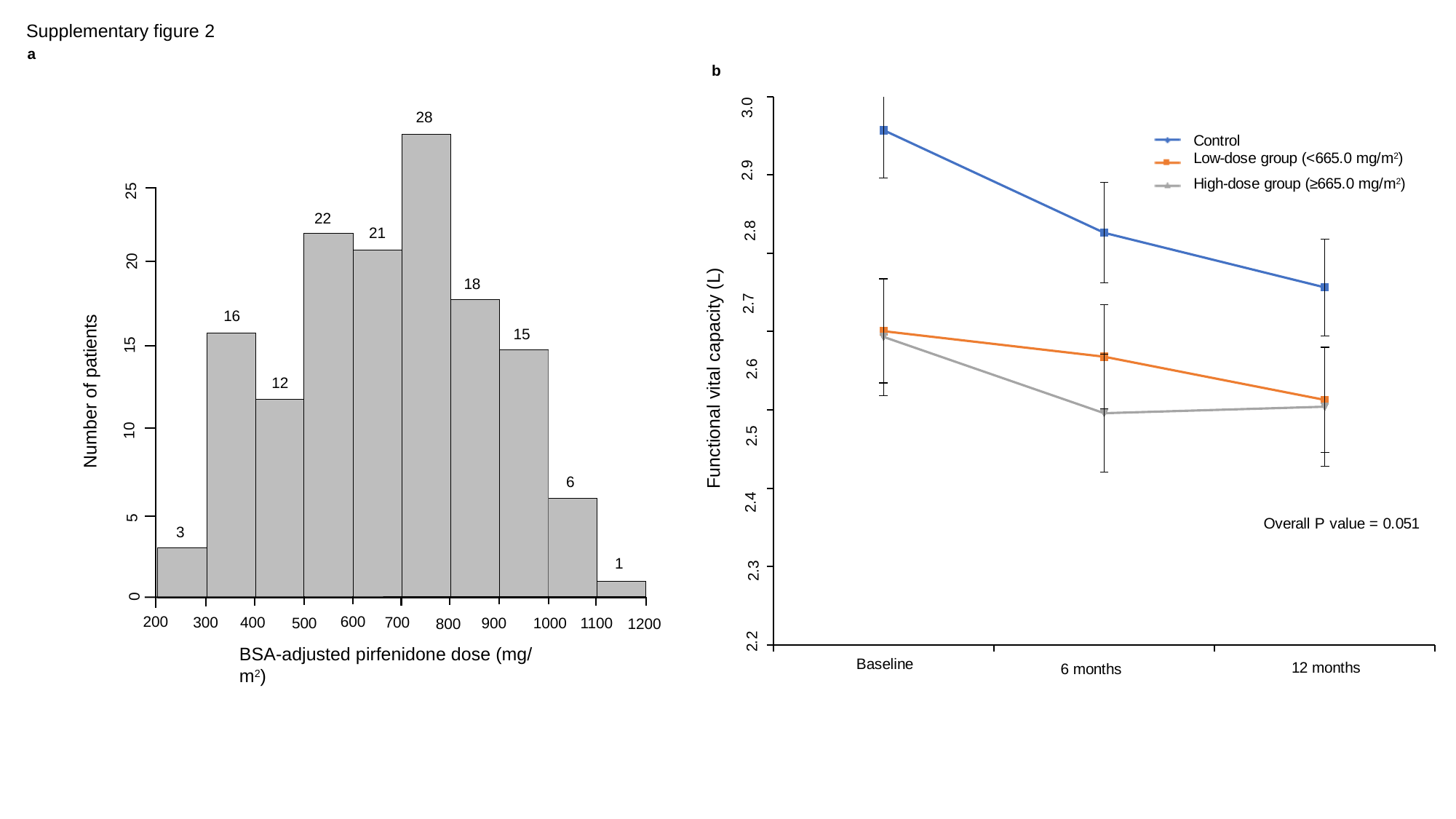
In the right chart (b), is the Control group's functional vital capacity at Baseline greater or less than 2.9 L? greater In the left chart (a), which bin has more patients: 800–900 or 900–1000 mg/m²? 800–900 mg/m² In the left chart (a), how many dose bins (bars) are shown? 10 In the right chart (b), which group has the higher functional vital capacity at 6 months: Control or High-dose group? Control In the left chart (a), how many patients have a BSA-adjusted pirfenidone dose between 700 and 800 mg/m²? 28 In the right chart (b), how many series does the legend list? 3 In the left chart (a), which dose bin has the lowest number of patients? 1100–1200 mg/m² In the left chart (a), what is the difference in number of patients between the 500–600 bin and the 400–500 bin? 10 What kind of chart is the left chart (a)? Bar chart In the right chart (b), does the Control group's functional vital capacity rise or fall from Baseline to 12 months? Fall In the left chart (a), which dose bin has the highest number of patients? 700–800 mg/m² In the left chart (a), how many patients fall in the 300–400 mg/m² dose bin? 16